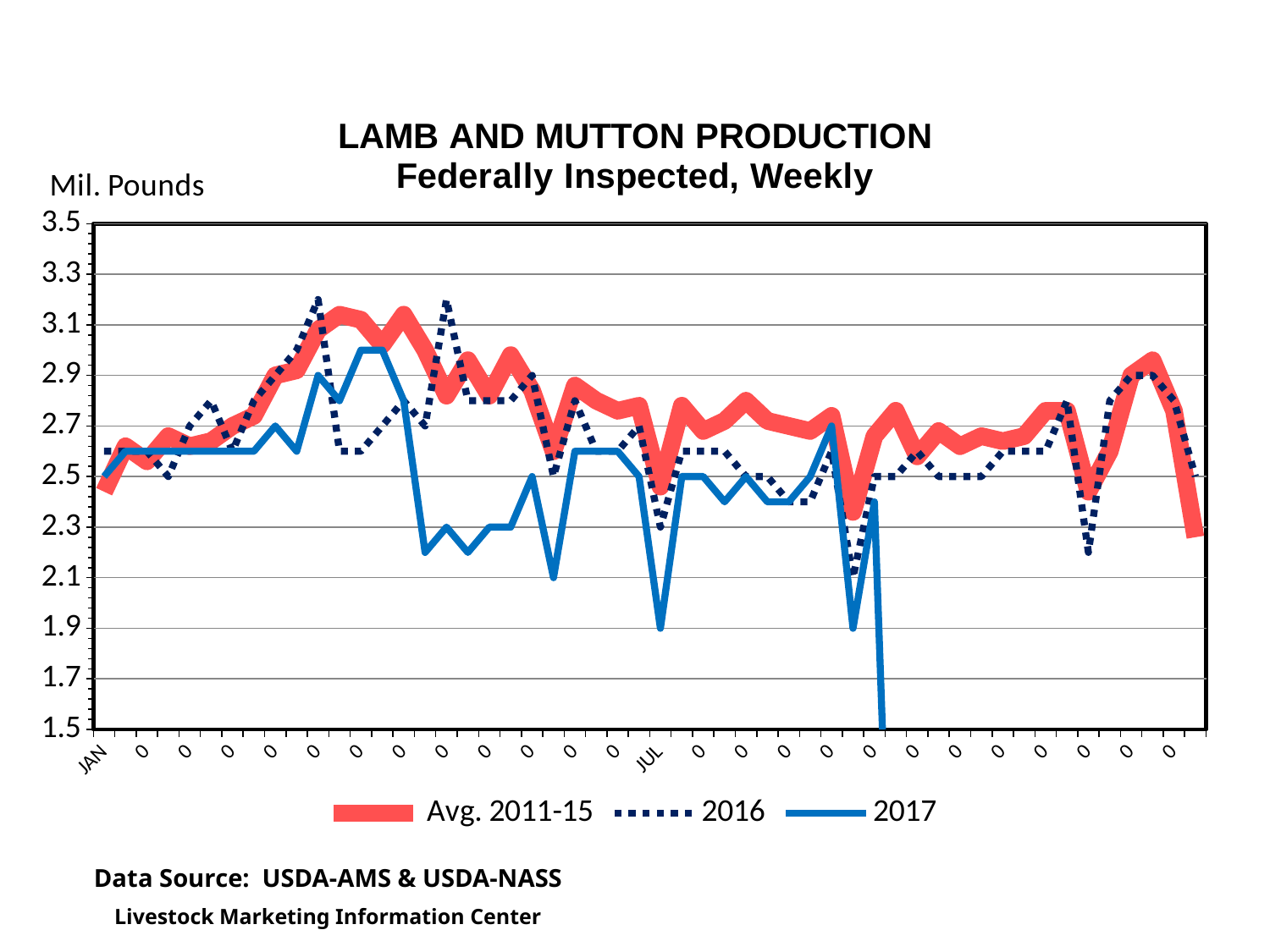
At JAN, which is higher, the 2016 line or the Avg. 2011-15 line? 2016 Is the highest point of the 2016 line greater or less than 3.1? greater What kind of chart is shown on the slide? Line chart Which series reaches the lowest value on the chart? 2017 What unit is shown on the vertical axis of the chart? Mil. Pounds At JUL, which is higher, the Avg. 2011-15 line or the 2017 line? Avg. 2011-15 Which series is drawn as a dotted line? 2016 Is the Avg. 2011-15 value at JUL greater or less than 2.5? less How many series does the legend list? 3 Is the value of the 2017 line at JAN greater or less than 2.7? less